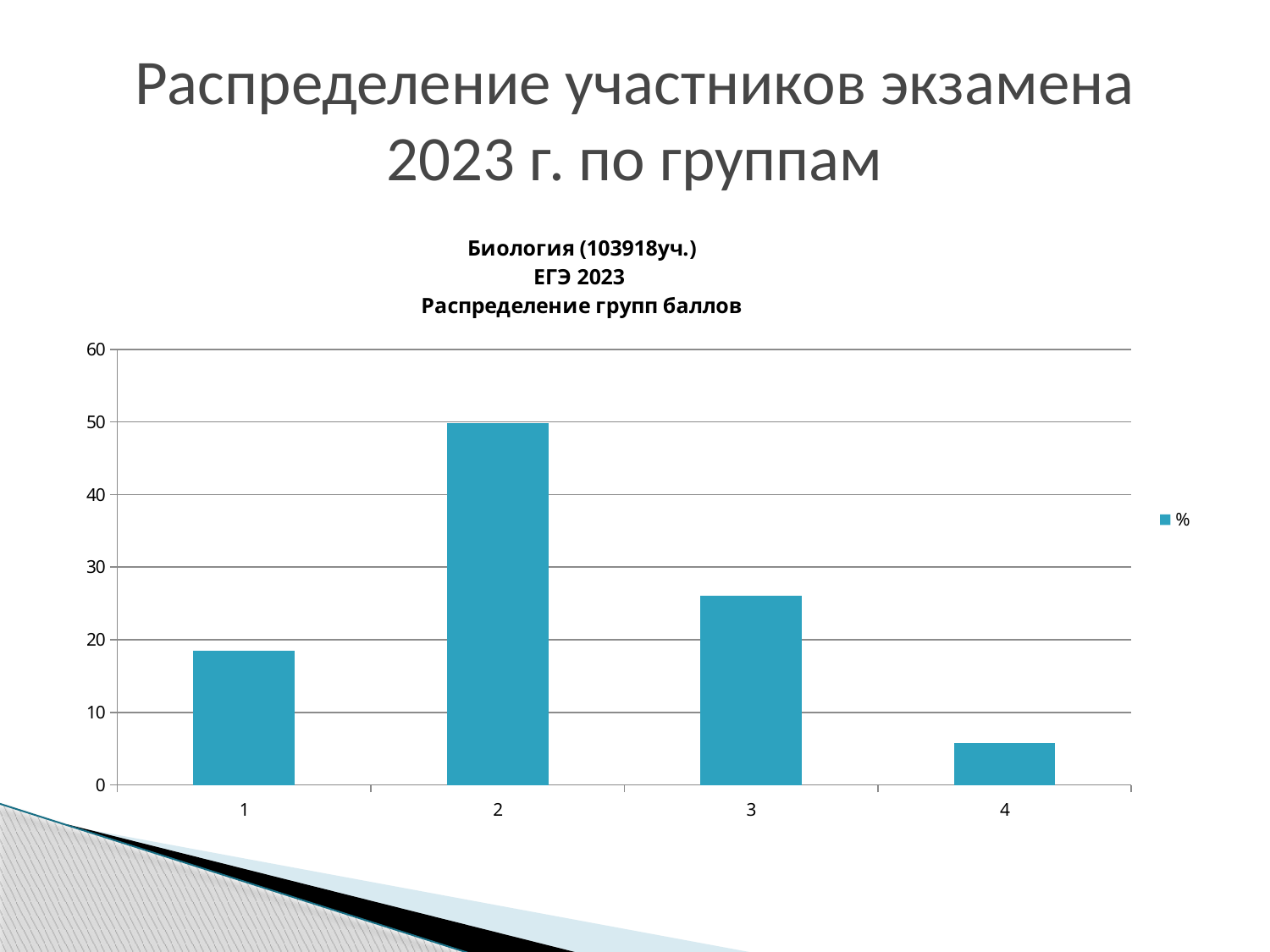
Which group has a larger value, group 1 or group 3? 3 How many series does the chart legend list? 1 Is the value for group 4 greater or less than 10? less Is the value for group 1 greater or less than 20? less What kind of chart is shown on the slide? bar chart What is the legend entry for the series in the chart? % Which group has a larger value, group 2 or group 3? 2 Is the value for group 2 greater or less than 40? greater How many groups (categories) are shown on the x axis of the chart? 4 Which group has the highest bar in the chart? 2 Which group has the lowest bar in the chart? 4